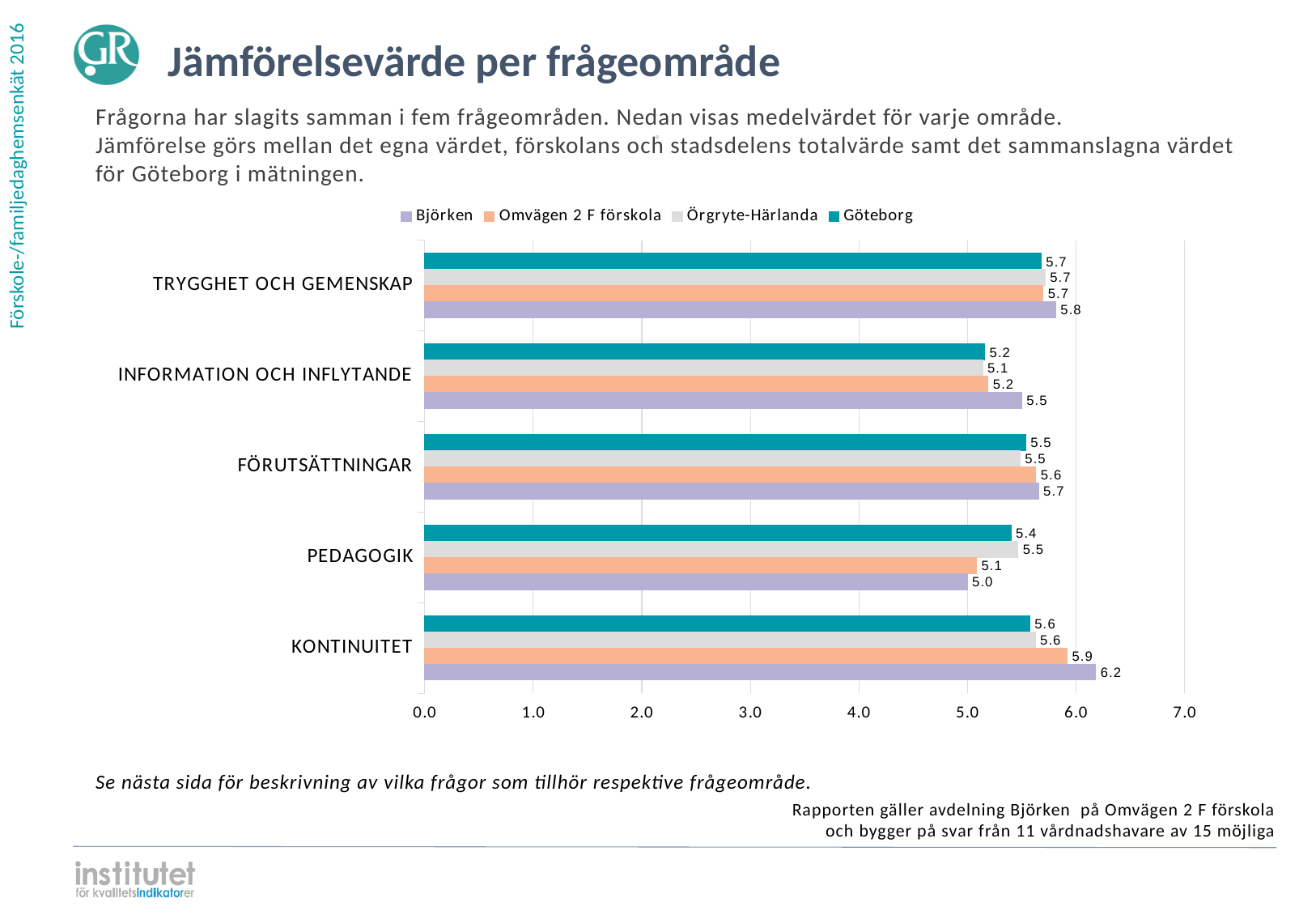
What is the value for Örgryte-Härlanda in the FÖRUTSÄTTNINGAR category? 5.5 What is the difference between the Björken value and the Göteborg value in the KONTINUITET category? 0.6 What is the value for Omvägen 2 F förskola in the INFORMATION OCH INFLYTANDE category? 5.2 What kind of chart is shown on the slide? Bar chart What is the value for Björken in the KONTINUITET category? 6.2 In the PEDAGOGIK category, which is larger: the value for Örgryte-Härlanda or the value for Björken? Örgryte-Härlanda In which category does Björken have its highest value? KONTINUITET What is the value for Göteborg in the PEDAGOGIK category? 5.4 How many series does the legend list? 4 In which category does Björken have its lowest value? PEDAGOGIK How many categories are shown on the chart? 5 Which series is shown in purple in the legend? Björken